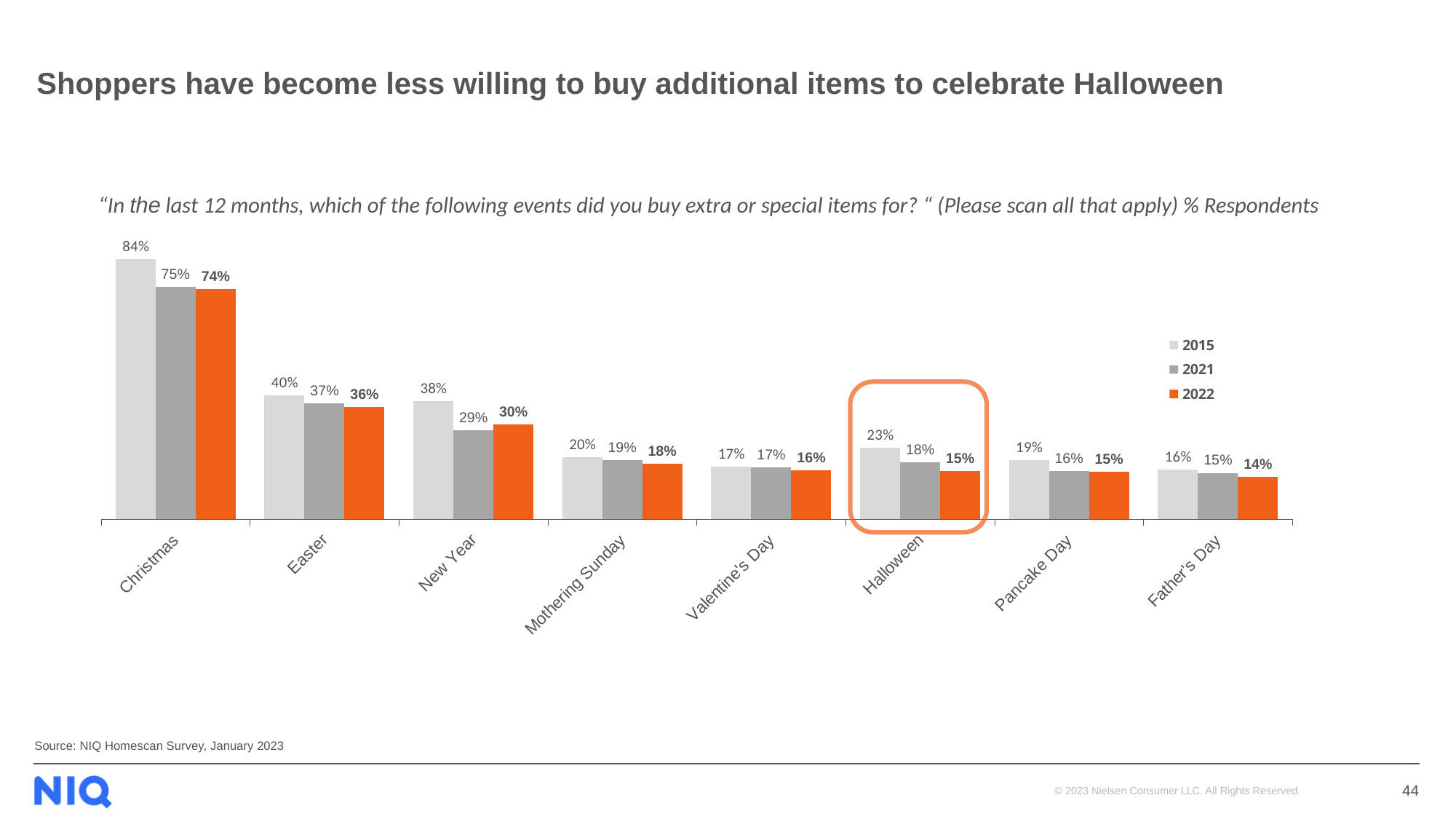
How many series does the legend list? 3 Which is larger: the 2022 value for Easter or the 2022 value for New Year? Easter By how many percentage points did the Halloween value fall from 2015 to 2022? 8 percentage points What percentage of respondents bought extra items for Halloween in 2022? 15% What was the value for Christmas in 2015? 84% Which event has the lowest value in 2022? Father's Day What kind of chart is shown on the slide? Bar chart Which event is highlighted with an orange rounded box? Halloween What is the difference between the 2015 and 2021 values for Christmas? 9 percentage points What was the value for New Year in 2021? 29% How many events are shown on the x axis? 8 Which event has the highest value in 2022? Christmas